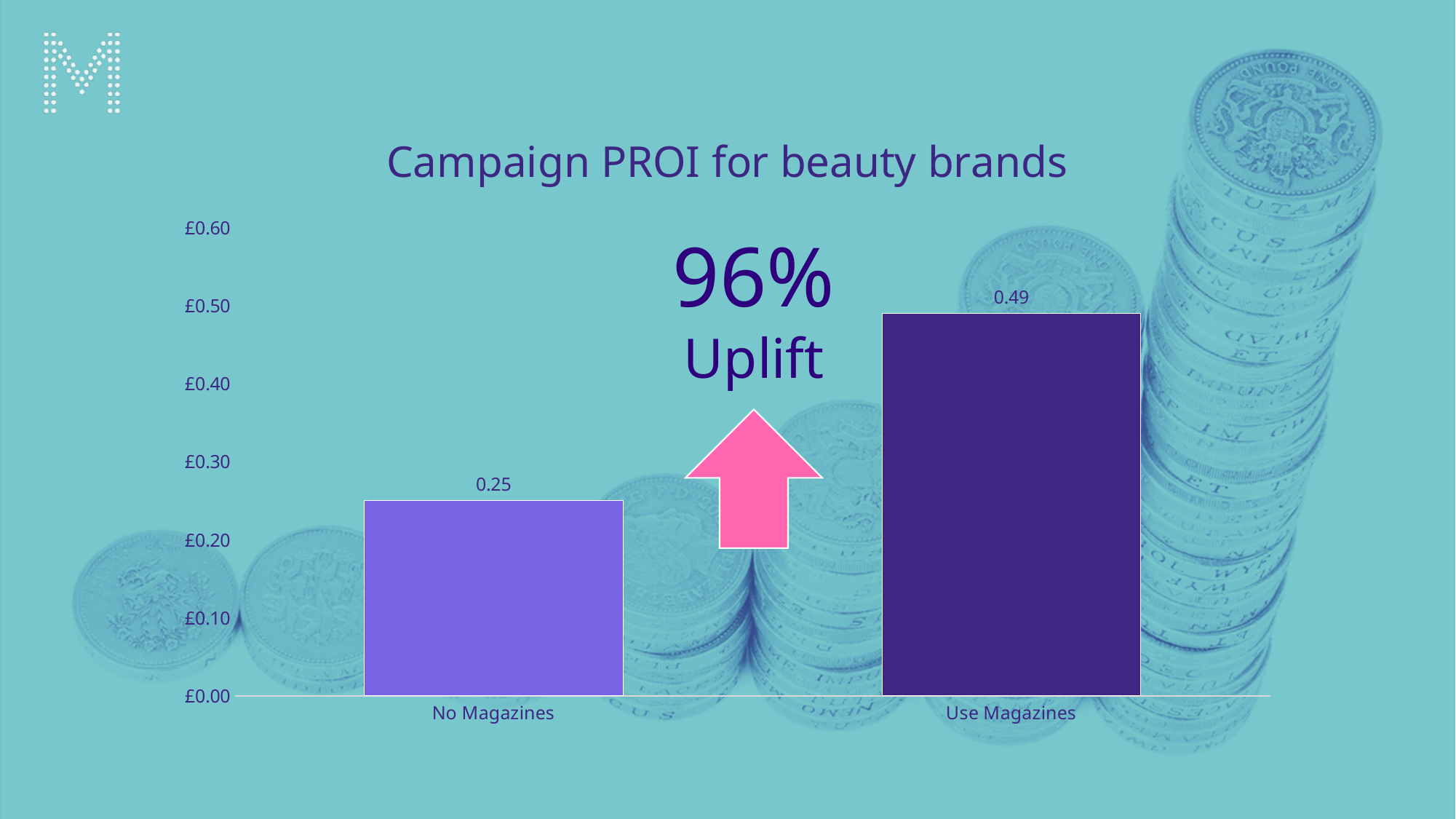
What is the value for Use Magazines? 0.49 Which is larger, the value for No Magazines or the value for Use Magazines? Use Magazines Is the value for No Magazines greater or less than £0.30? less What is the difference between the values for Use Magazines and No Magazines? 0.24 What is the value for No Magazines? 0.25 How many categories are shown on the chart? 2 What is the title of the chart? Campaign PROI for beauty brands What kind of chart is shown on the slide? bar chart Which category has the highest value? Use Magazines Is the value for Use Magazines greater or less than £0.40? greater What uplift percentage is annotated on the chart? 96% Which category has the lowest value? No Magazines